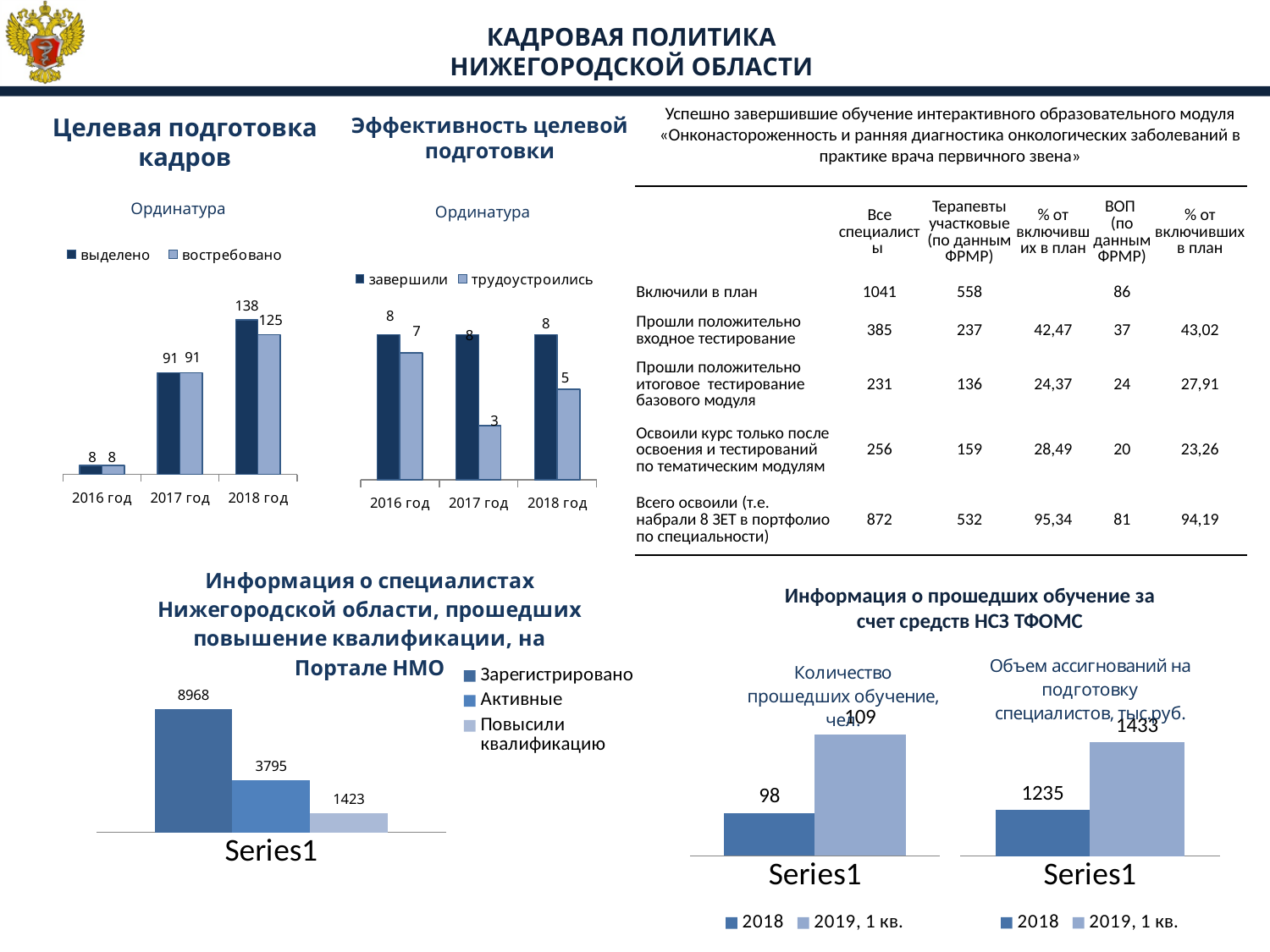
How many series does the legend of the 'Эффективность целевой подготовки' chart list? 2 In the 'Количество прошедших обучение, чел.' chart, what is the value for 2018? 98 In the chart 'Информация о специалистах Нижегородской области, прошедших повышение квалификации, на Портале НМО', what is the difference between 'Зарегистрировано' and 'Повысили квалификацию'? 7545 In the 'Объем ассигнований на подготовку специалистов, тыс.руб.' chart, which is larger: 2018 or 2019, 1 кв.? 2019, 1 кв. In the chart 'Информация о специалистах Нижегородской области, прошедших повышение квалификации, на Портале НМО', what is the value for 'Активные'? 3795 In the 'Целевая подготовка кадров' chart, what is the difference between 'выделено' and 'востребовано' in 2018 год? 13 In the 'Эффективность целевой подготовки' chart, which year has the highest 'трудоустроились' value? 2016 год In the 'Целевая подготовка кадров' chart, which year has the lowest 'выделено' value? 2016 год In the 'Целевая подготовка кадров' chart, what is the value of 'востребовано' for 2018 год? 125 What type of chart is the 'Объем ассигнований на подготовку специалистов, тыс.руб.' chart? bar chart In the 'Целевая подготовка кадров' chart, what is the value of 'выделено' for 2018 год? 138 In the 'Эффективность целевой подготовки' chart, what is the value of 'трудоустроились' for 2017 год? 3